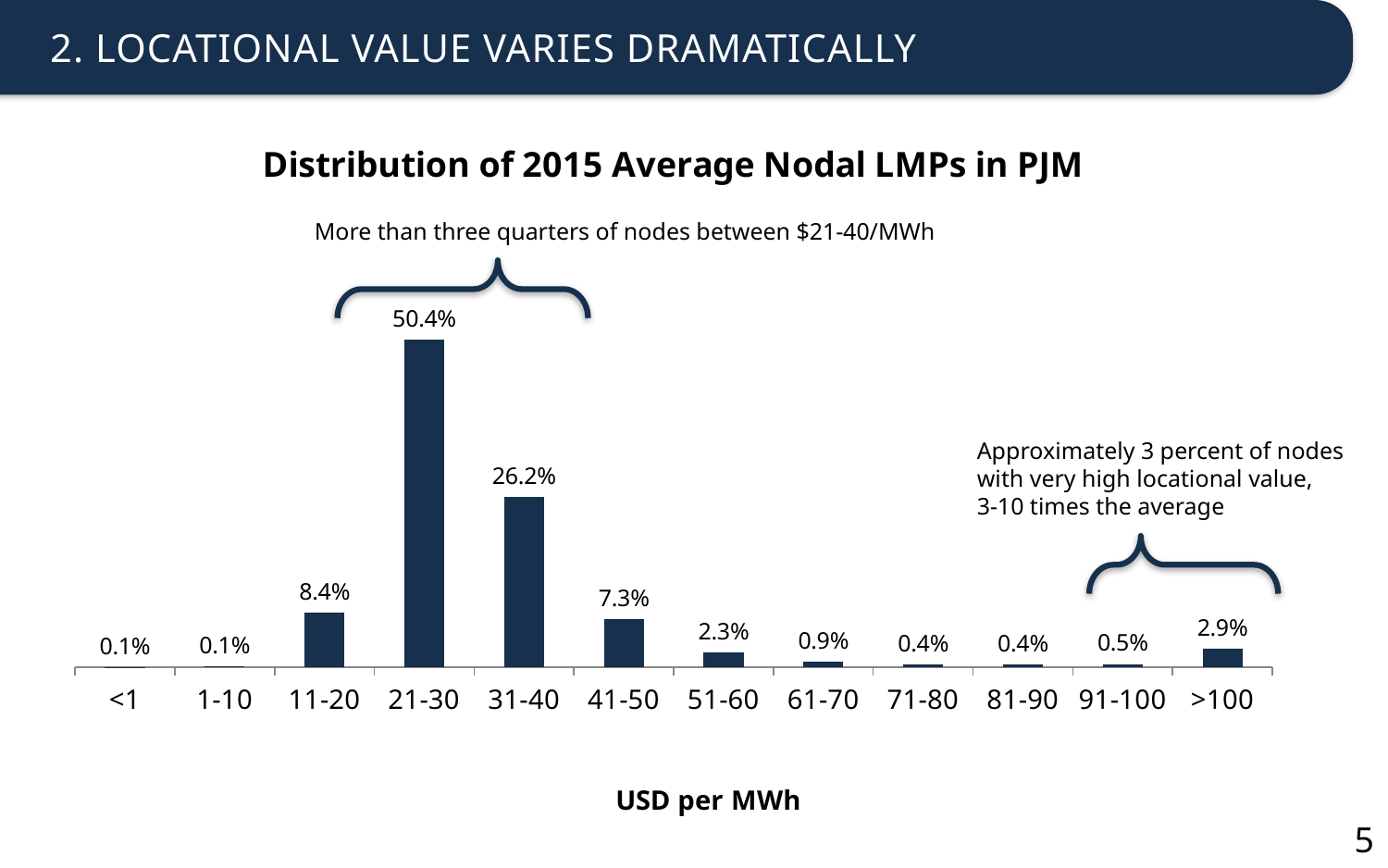
What is the value shown for the 31-40 category? 26.2% What kind of chart is shown on the slide? Bar chart Which is larger, the value for 11-20 or the value for 41-50? 11-20 Which category has the highest value? 21-30 What percentage of nodes fall in the 21-30 USD per MWh bin? 50.4% How many categories are shown on the x axis? 12 What is the combined value of the 21-30 and 31-40 categories? 76.6% What is the difference between the 21-30 and 31-40 values? 24.2% What percentage of nodes have an average LMP above 100 USD per MWh (>100 category)? 2.9% What is the value shown for the 51-60 category? 2.3% What is the x-axis label of the chart? USD per MWh What is the title of the chart? Distribution of 2015 Average Nodal LMPs in PJM